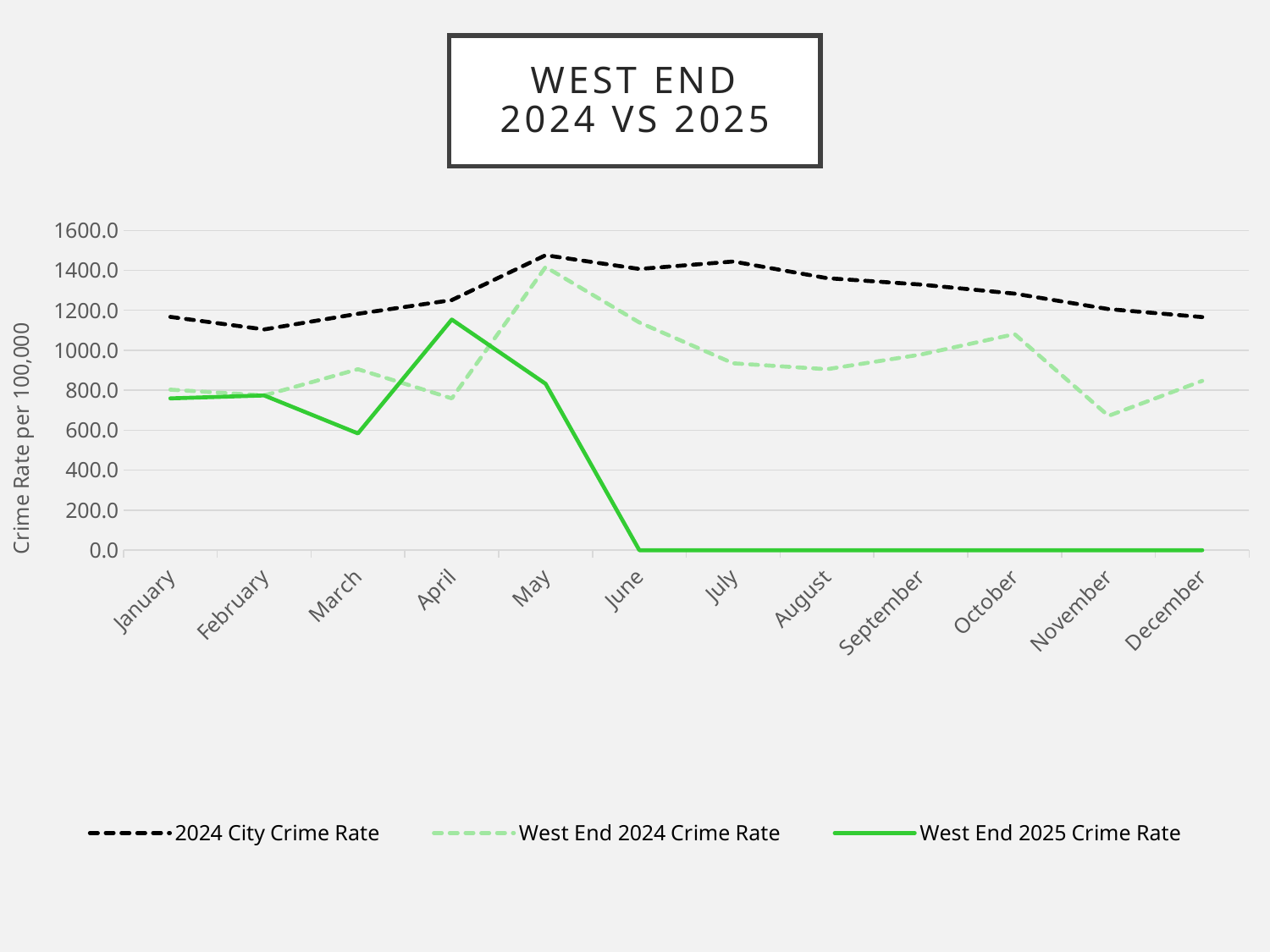
How many months are plotted along the x axis? 12 What kind of chart is shown on the slide? line chart In which month is the West End 2024 Crime Rate highest? May What is the West End 2025 Crime Rate value for December? 0.0 What is the West End 2025 Crime Rate value for June? 0.0 Is the 2024 City Crime Rate for January greater or less than 1000? greater In which month is the West End 2025 Crime Rate highest? April What is the label on the vertical axis? Crime Rate per 100,000 Is the West End 2025 Crime Rate for March greater or less than 800? less In which month is the West End 2024 Crime Rate lowest? November In April, which is higher: the West End 2024 Crime Rate or the West End 2025 Crime Rate? West End 2025 Crime Rate How many series does the legend list? 3